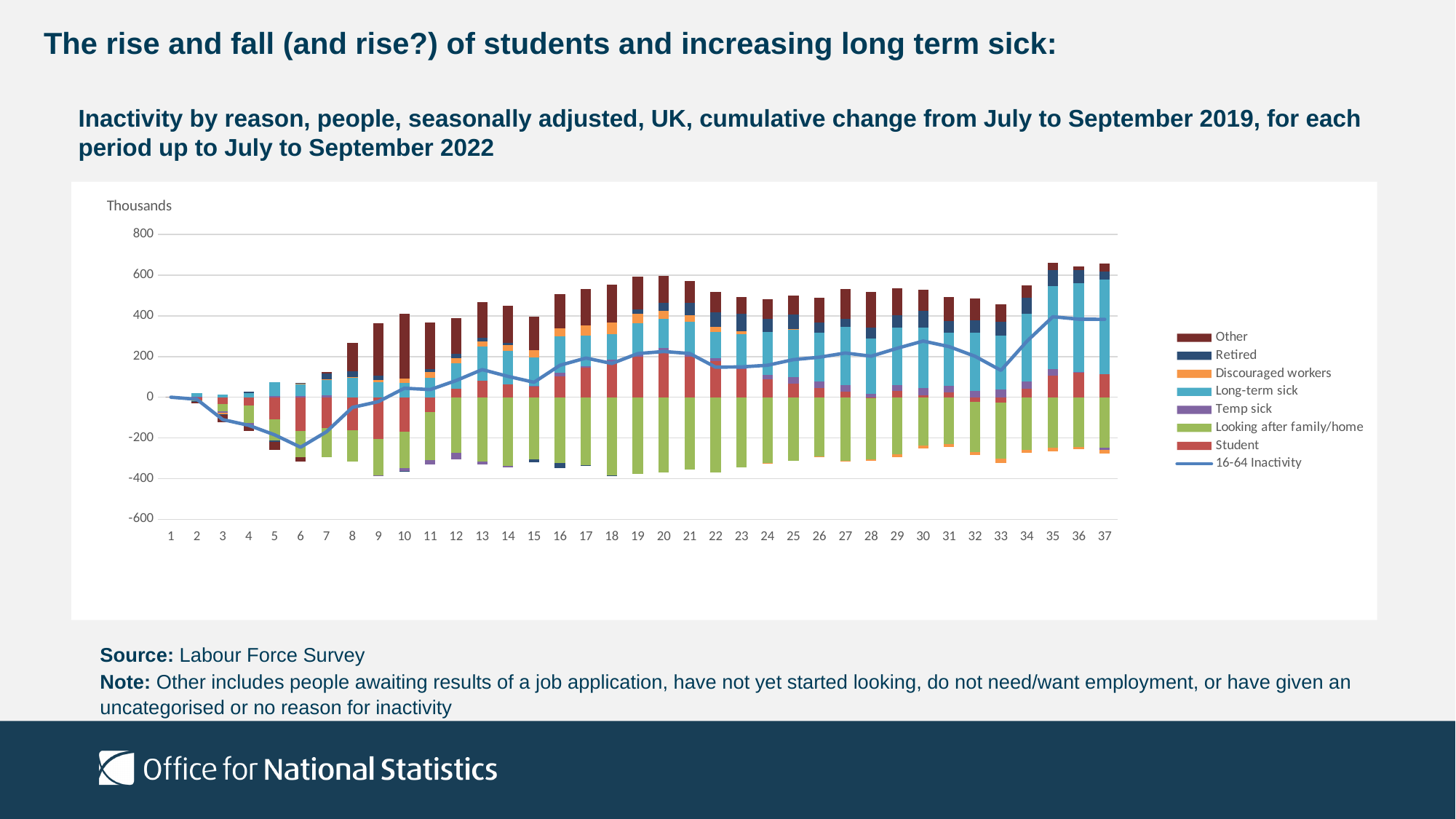
At which period does the 16-64 Inactivity line reach its lowest value? 6 What kind of chart is shown on the slide? A stacked bar chart with a line series How many periods are shown along the x axis of the chart? 37 Does the 16-64 Inactivity line rise or fall between period 6 and period 20? rise Is the top of the positive stacked bar at period 35 greater or less than 600? greater What unit is shown on the chart's vertical axis? Thousands Is the value of the 16-64 Inactivity line at period 35 greater or less than 200? greater Is the top of the positive stacked bar at period 8 greater or less than 400? less Which series in the legend is drawn as a line rather than bars? 16-64 Inactivity How many series does the chart's legend list? 8